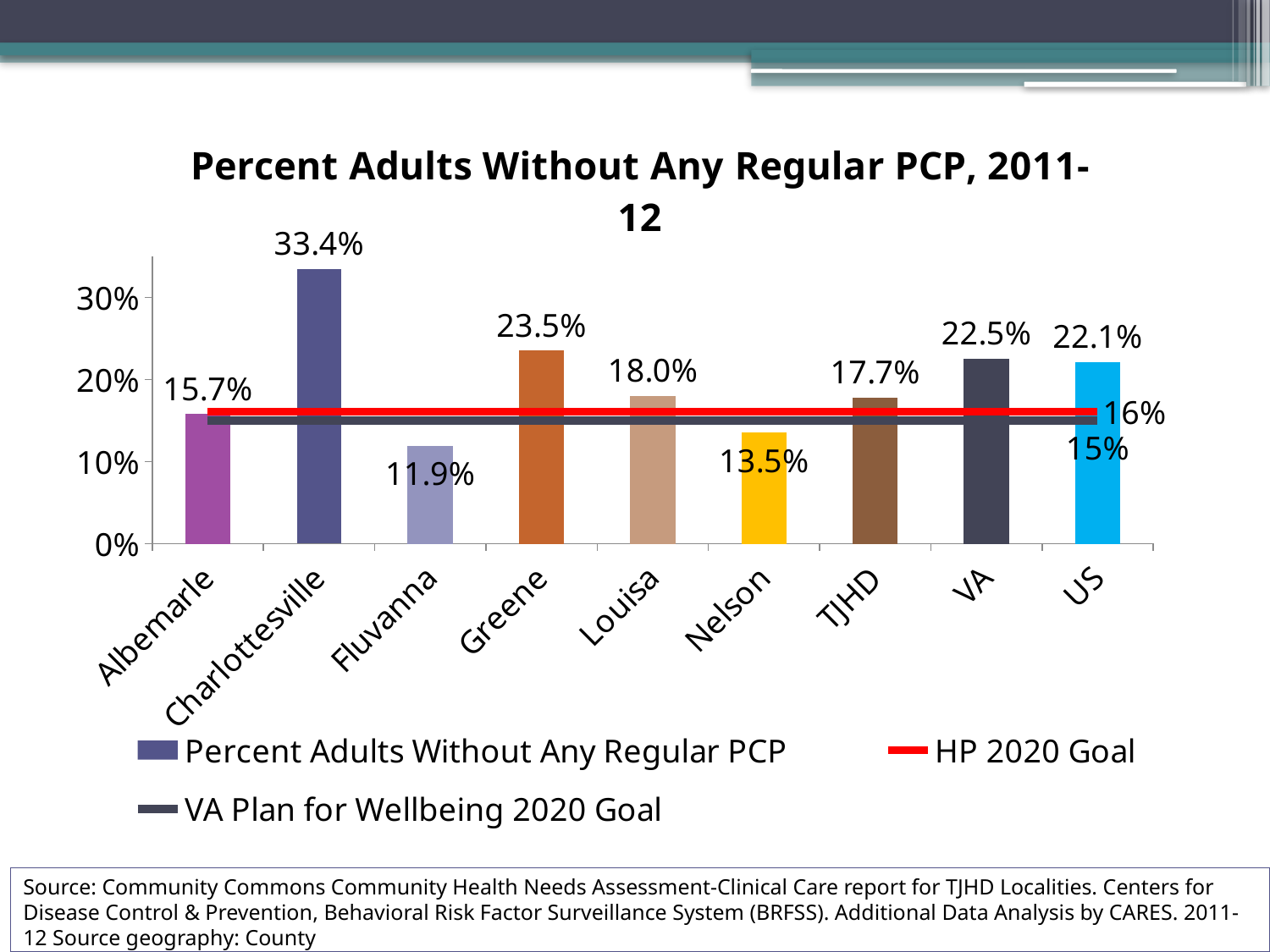
What kind of chart is this? Combination bar and line chart What is the difference between the values for Charlottesville and Albemarle? 17.7% How many categories are shown on the x axis? 9 What is the value of the HP 2020 Goal line? 16% What is the title of the chart? Percent Adults Without Any Regular PCP, 2011-12 What is the value for Fluvanna? 11.9% Which category has the lowest percent of adults without any regular PCP? Fluvanna What is the value for TJHD? 17.7% Which category has the highest percent of adults without any regular PCP? Charlottesville Which is larger, the value for VA or the value for US? VA How many series does the legend list? 3 What is the value for Charlottesville? 33.4%